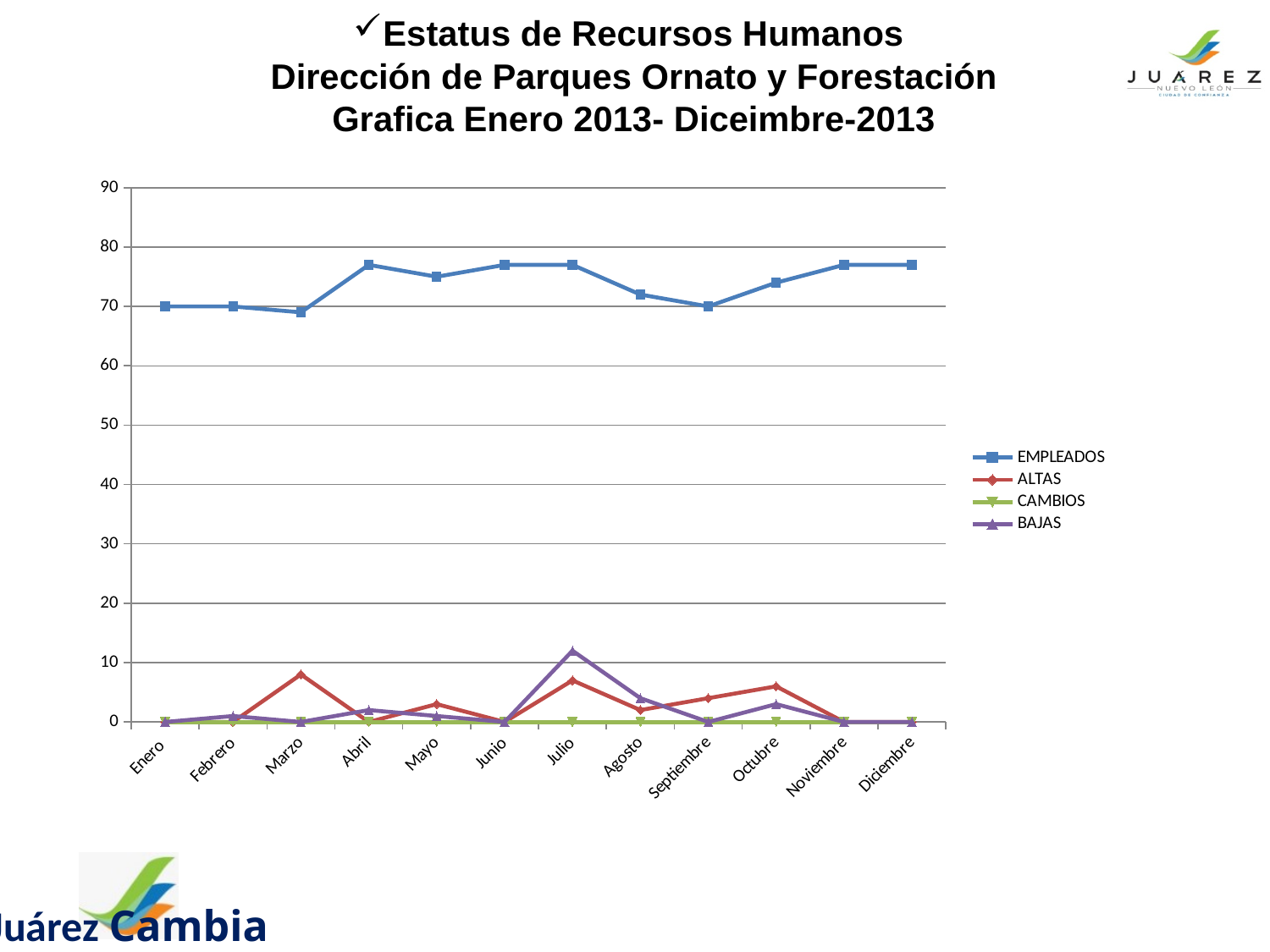
In Julio, which is larger: ALTAS or BAJAS? BAJAS How many series does the legend list? 4 Is the EMPLEADOS value for Septiembre greater or less than 80? less What is the EMPLEADOS value for Enero? 70 In which month does the BAJAS series reach its highest value? Julio Does the EMPLEADOS series rise or fall from Septiembre to Noviembre? rise What is the ALTAS value for Junio? 0 What kind of chart is shown on the slide? line chart How many months are plotted along the x axis? 12 Is the BAJAS value for Julio greater or less than 10? greater In Octubre, which is larger: ALTAS or BAJAS? ALTAS Is the EMPLEADOS value for Abril greater or less than 70? greater